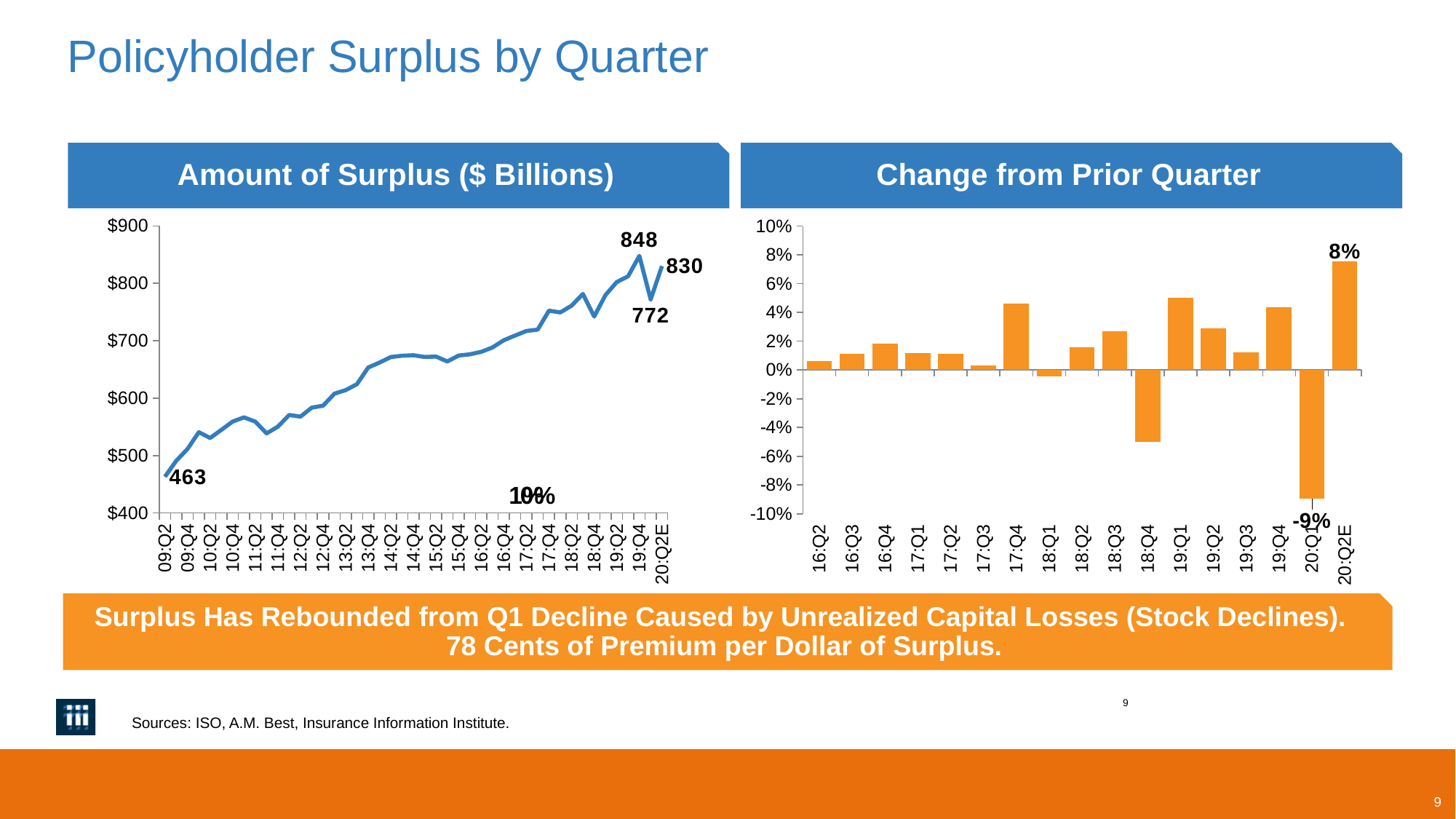
In the "Amount of Surplus ($ Billions)" chart, what is the value for 20:Q1? 772 How many quarters are shown on the x axis of the "Change from Prior Quarter" chart? 17 In the "Change from Prior Quarter" chart, what is the value for 20:Q1? -9% In the "Amount of Surplus ($ Billions)" chart, what is the value for 09:Q2? 463 In the "Amount of Surplus ($ Billions)" chart, what is the value for 20:Q2E? 830 In the "Amount of Surplus ($ Billions)" chart, which is higher, 19:Q4 or 20:Q2E? 19:Q4 In the "Amount of Surplus ($ Billions)" chart, what is the value for 19:Q4? 848 In the "Amount of Surplus ($ Billions)" chart, what is the difference between the 19:Q4 value and the 20:Q1 value? 76 What kind of chart is the "Amount of Surplus ($ Billions)" chart? line chart In the "Change from Prior Quarter" chart, what is the value for 20:Q2E? 8% What kind of chart is the "Change from Prior Quarter" chart? bar chart In the "Change from Prior Quarter" chart, which quarter has the lowest value? 20:Q1